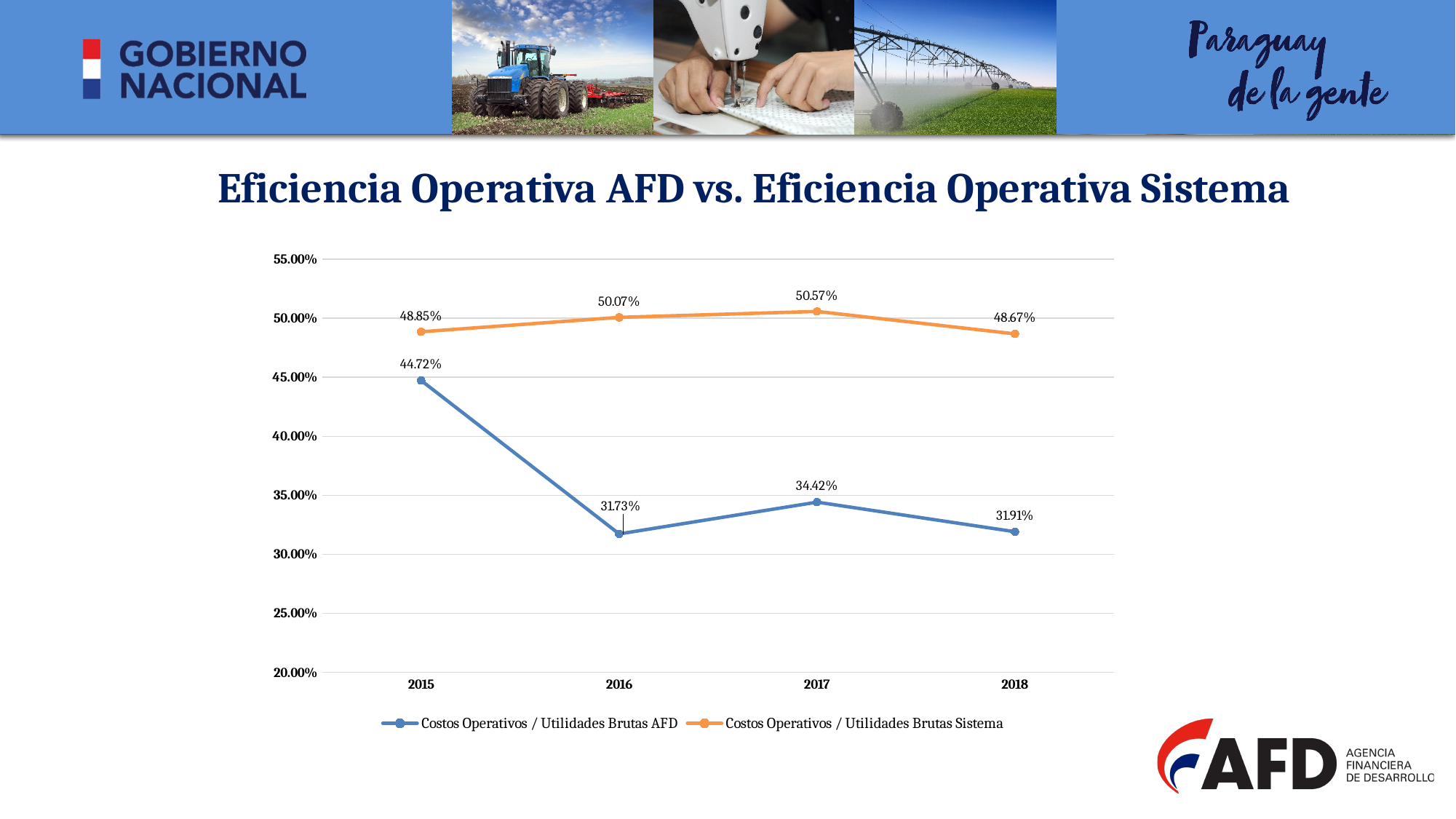
What is the value of Costos Operativos / Utilidades Brutas AFD in 2015? 44.72% What is the difference between the Sistema and AFD values in 2016? 18.34% Which is larger in 2018: the AFD value or the Sistema value? Sistema (48.67%) How many series does the legend list? 2 What is the value of Costos Operativos / Utilidades Brutas AFD in 2018? 31.91% What is the value of Costos Operativos / Utilidades Brutas Sistema in 2017? 50.57% What kind of chart is shown on the slide? line chart In which year is Costos Operativos / Utilidades Brutas Sistema highest? 2017 What is the title of the chart? Eficiencia Operativa AFD vs. Eficiencia Operativa Sistema In which year is Costos Operativos / Utilidades Brutas AFD lowest? 2016 How many years are shown on the x axis? 4 Is the AFD value for 2017 greater or less than 35.00%? less